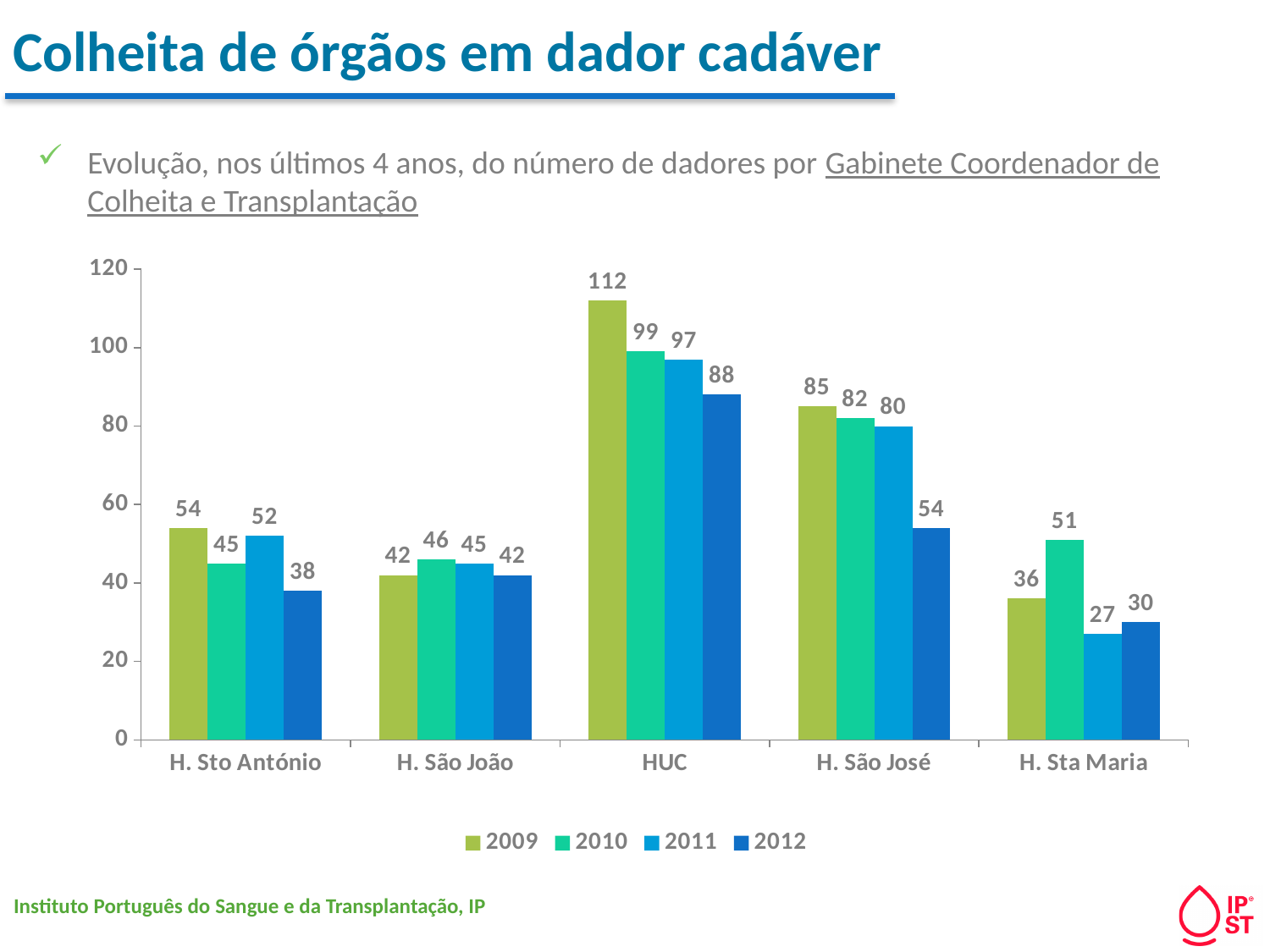
How many series does the legend list? 4 How many categories are shown on the x axis? 5 Is the 2011 value for H. São José greater or less than 60? greater Which is larger: the 2010 value for H. Sto António or the 2010 value for H. São João? H. São João What is the value for H. Sta Maria in 2011? 27 What kind of chart is shown on the slide? bar chart Do the values for H. São José rise or fall from 2009 to 2012? fall Which category has the lowest value in 2009? H. Sta Maria What is the difference between the 2009 and 2012 values for HUC? 24 Which category has the highest value in 2012? HUC What is the value for H. São José in 2012? 54 What is the value for HUC in 2009? 112